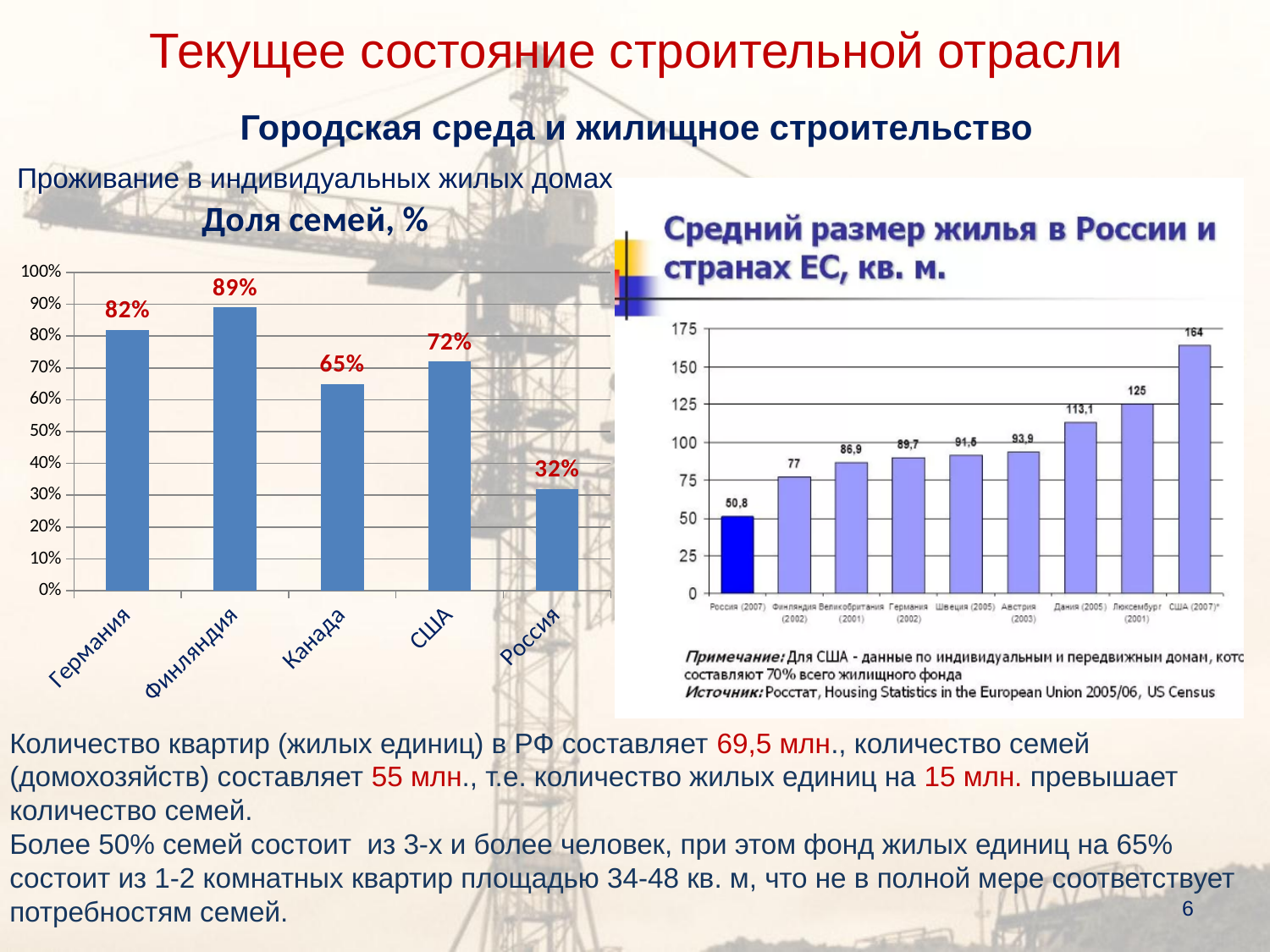
On the chart 'Доля семей, %', how many countries are shown? 5 On the chart 'Доля семей, %', which country has the highest share? Финляндия On the chart 'Средний размер жилья в России и странах ЕС, кв. м', which country has the highest value? США (2007) On the chart 'Доля семей, %', which country has the lowest share? Россия On the chart 'Средний размер жилья в России и странах ЕС, кв. м', which is larger: Дания (2005) or Австрия (2003)? Дания (2005) On the chart 'Средний размер жилья в России и странах ЕС, кв. м', what is the value for Люксембург (2001)? 125 On the chart 'Доля семей, %', what is the value for Финляндия? 89% On the chart 'Средний размер жилья в России и странах ЕС, кв. м', how many countries are shown? 9 On the chart 'Доля семей, %', what is the value for Россия? 32% On the chart 'Средний размер жилья в России и странах ЕС, кв. м', what is the value for Россия (2007)? 50,8 On the chart 'Доля семей, %', what is the difference between Германия and Канада? 17% What type of chart is 'Средний размер жилья в России и странах ЕС, кв. м'? Bar chart